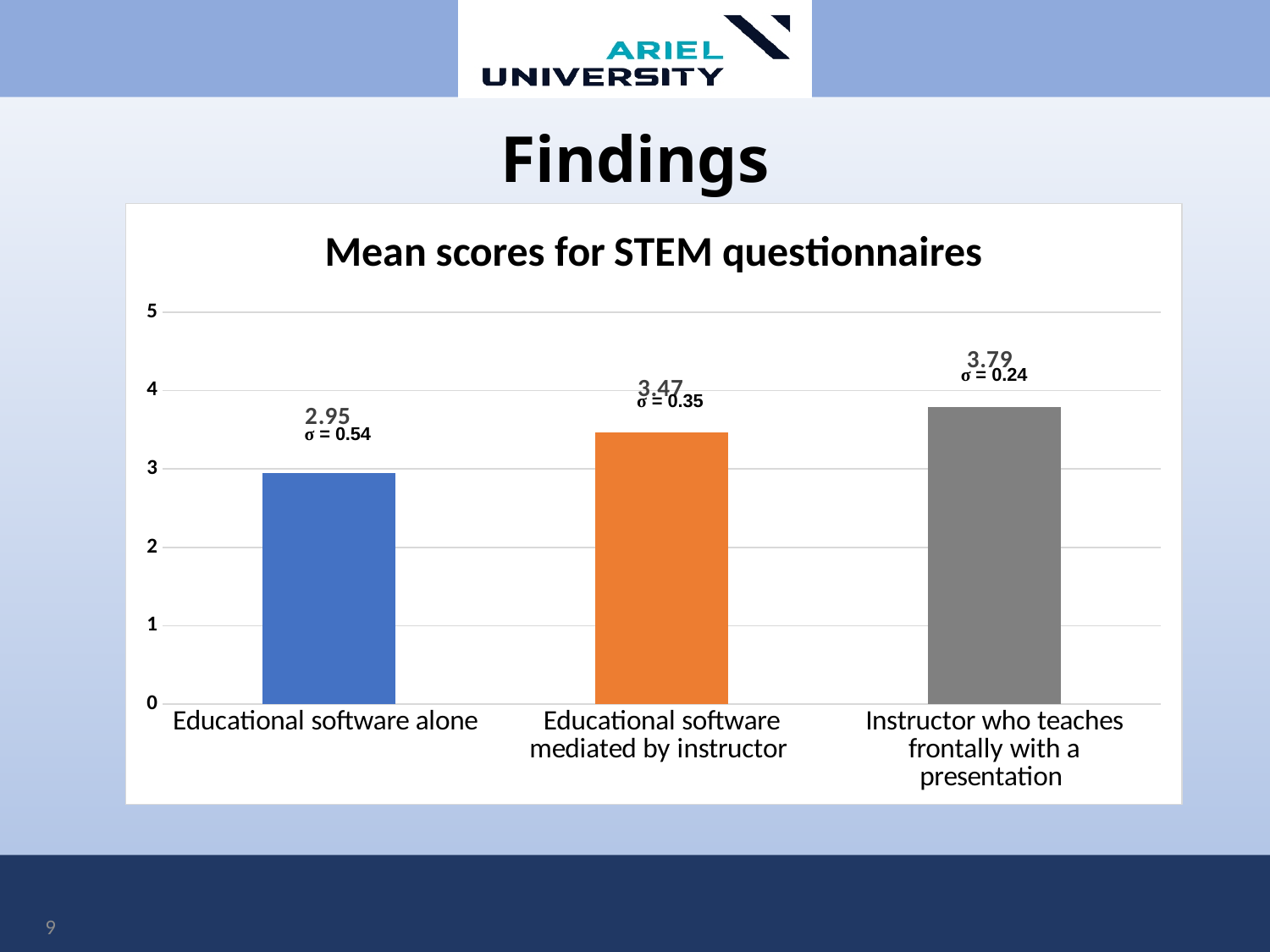
What is the difference between the mean scores for Instructor who teaches frontally with a presentation and Educational software alone? 0.84 Which has a higher mean score: Educational software alone or Educational software mediated by instructor? Educational software mediated by instructor What is the mean score for Instructor who teaches frontally with a presentation? 3.79 What is the difference between the mean scores for Educational software mediated by instructor and Educational software alone? 0.52 Which category has the lowest mean score? Educational software alone What is the mean score for Educational software alone? 2.95 Is the mean score for Instructor who teaches frontally with a presentation greater or less than 4? less What kind of chart is shown on the slide? bar chart What is the title of the chart? Mean scores for STEM questionnaires Which category has the highest mean score? Instructor who teaches frontally with a presentation What is the mean score for Educational software mediated by instructor? 3.47 How many categories are shown in the chart? 3